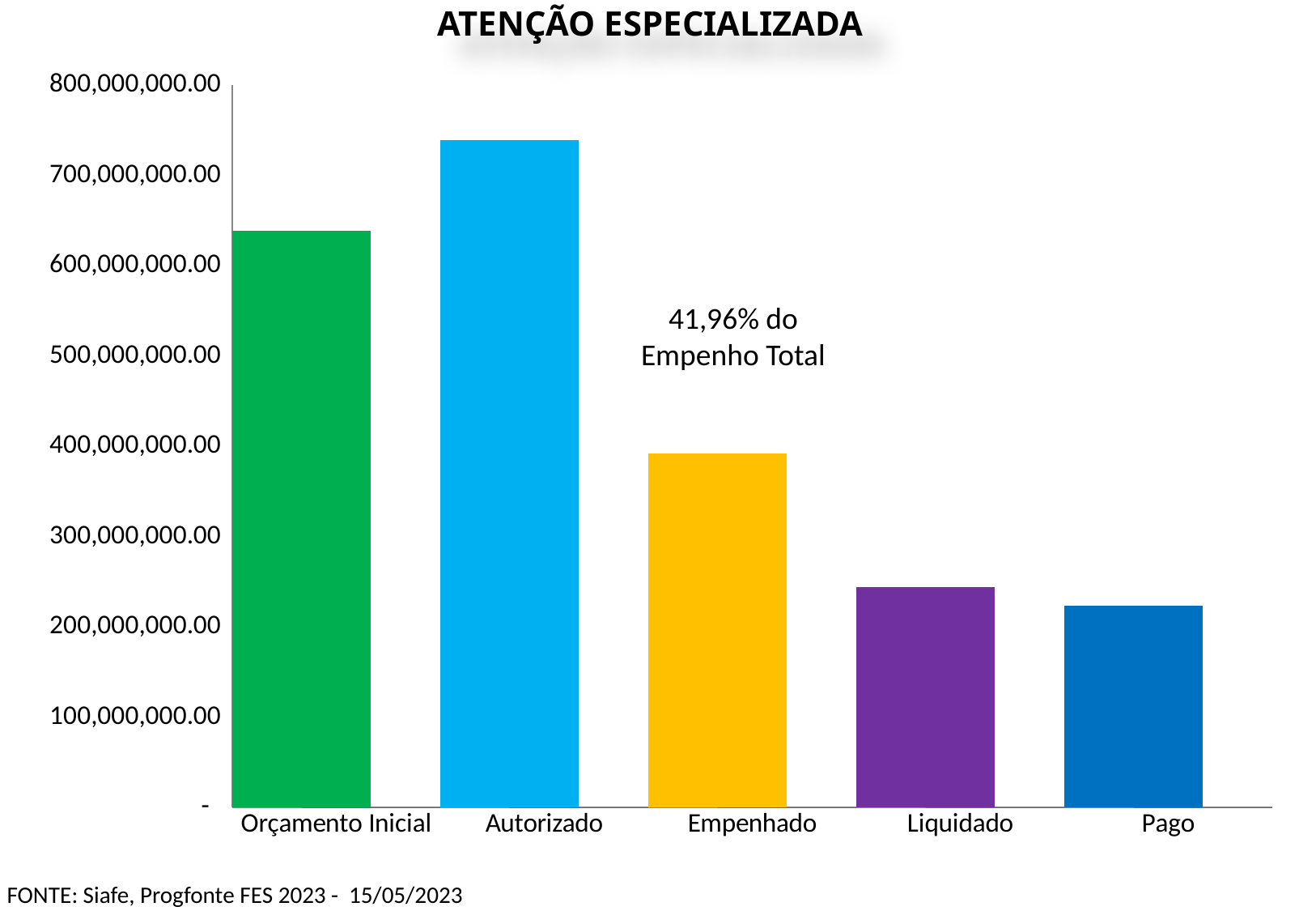
How many categories are shown on the x axis of the chart? 5 Which is larger, the value for Empenhado or the value for Liquidado? Empenhado What is the title of the chart? ATENÇÃO ESPECIALIZADA Is the value for Pago greater or less than 200,000,000.00? greater Is the value for Orçamento Inicial greater or less than 600,000,000.00? greater Which is larger, the value for Orçamento Inicial or the value for Autorizado? Autorizado What kind of chart is shown on the slide? bar chart From Autorizado to Pago, do the bar values rise or fall along the x axis? fall Which category has the highest bar in the chart? Autorizado Which category has the lowest bar in the chart? Pago Is the value for Autorizado greater or less than 700,000,000.00? greater